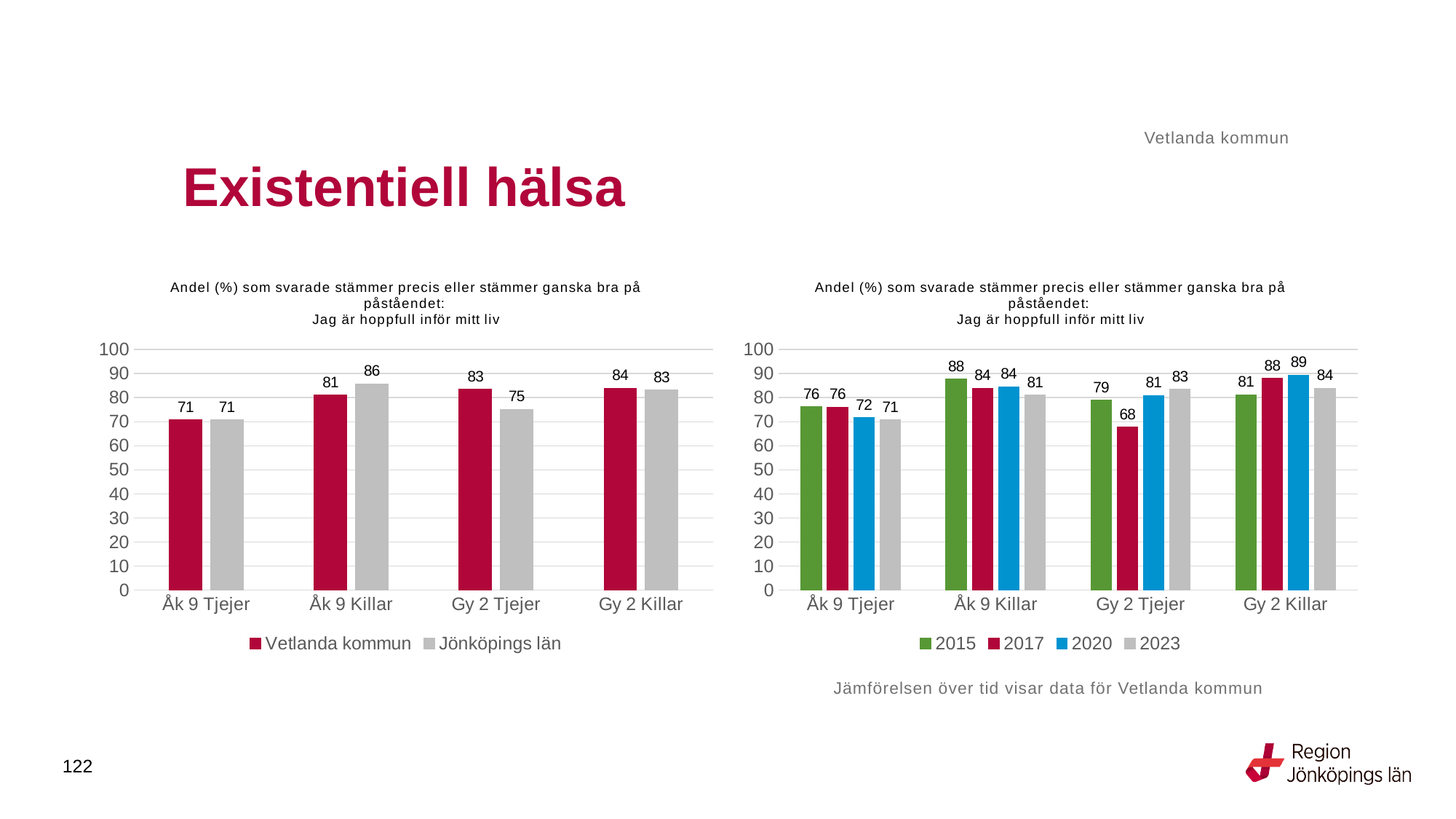
In the left chart, what is the difference between Vetlanda kommun and Jönköpings län for Gy 2 Tjejer? 8 In the left chart, what is the value for Vetlanda kommun for Åk 9 Killar? 81 In the right chart, what is the value for 2020 for Gy 2 Killar? 89 In the right chart, which year has the lowest value for Åk 9 Tjejer? 2023 In the left chart, what is the value for Jönköpings län for Gy 2 Tjejer? 75 In the right chart, how many series does the legend list? 4 In the left chart, which category has the highest value for Jönköpings län? Åk 9 Killar In the right chart, which is larger for Åk 9 Killar: the 2015 value or the 2023 value? 2015 In the right chart, what is the value for 2017 for Gy 2 Tjejer? 68 In the right chart, how many categories are shown on the x axis? 4 What type of chart is the left chart? Bar chart In the left chart, how many series does the legend list? 2